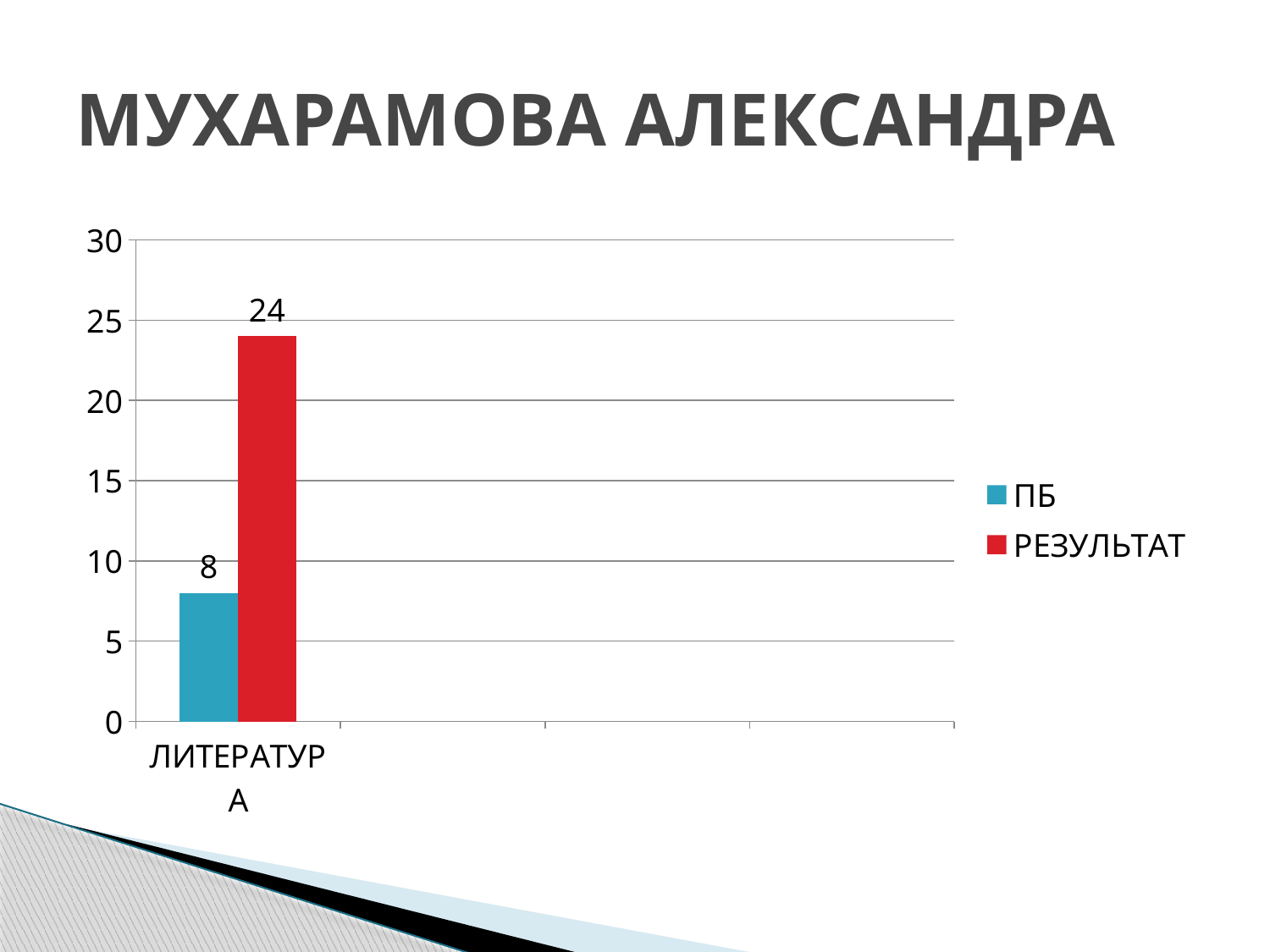
What is the maximum value shown on the vertical axis? 30 What is the title of the slide? МУХАРАМОВА АЛЕКСАНДРА Which series has the higher value for ЛИТЕРАТУРА, ПБ or РЕЗУЛЬТАТ? РЕЗУЛЬТАТ What is the value of ПБ for ЛИТЕРАТУРА? 8 Is the value of РЕЗУЛЬТАТ for ЛИТЕРАТУРА greater or less than 20? greater What colour is the РЕЗУЛЬТАТ series in the chart? red What is the value of РЕЗУЛЬТАТ for ЛИТЕРАТУРА? 24 How many series does the legend list? 2 What is the difference between РЕЗУЛЬТАТ and ПБ for ЛИТЕРАТУРА? 16 Is the value of ПБ for ЛИТЕРАТУРА greater or less than 10? less How many categories are shown on the x axis? 1 What kind of chart is shown on the slide? bar chart